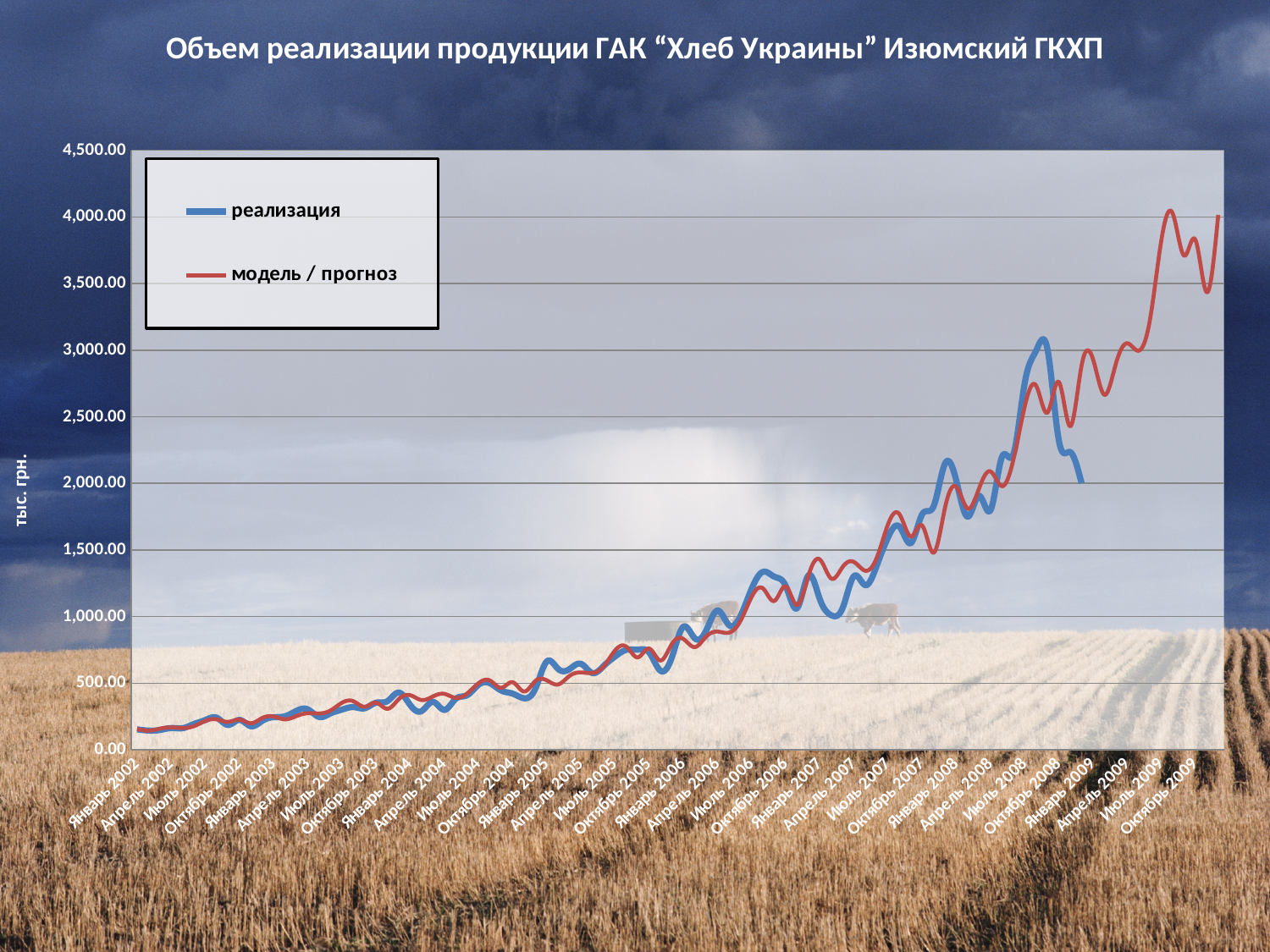
How many labels are shown on the horizontal axis? 32 Is the value of модель / прогноз at Октябрь 2009 greater or less than 3,500.00? greater What kind of chart is shown on the slide? line chart Is the value of модель / прогноз at Апрель 2009 greater or less than 3,500.00? less Is the value of реализация at Январь 2006 greater or less than 1,000.00? less Which series reaches the highest value on the chart? модель / прогноз What is the title of the chart? Объем реализации продукции ГАК “Хлеб Украины” Изюмский ГКХП What is the label on the vertical axis? тыс. грн. What are the two series named in the legend? реализация; модель / прогноз Do the values of the реализация series generally rise or fall from Январь 2002 to Июль 2008? rise How many series does the legend list? 2